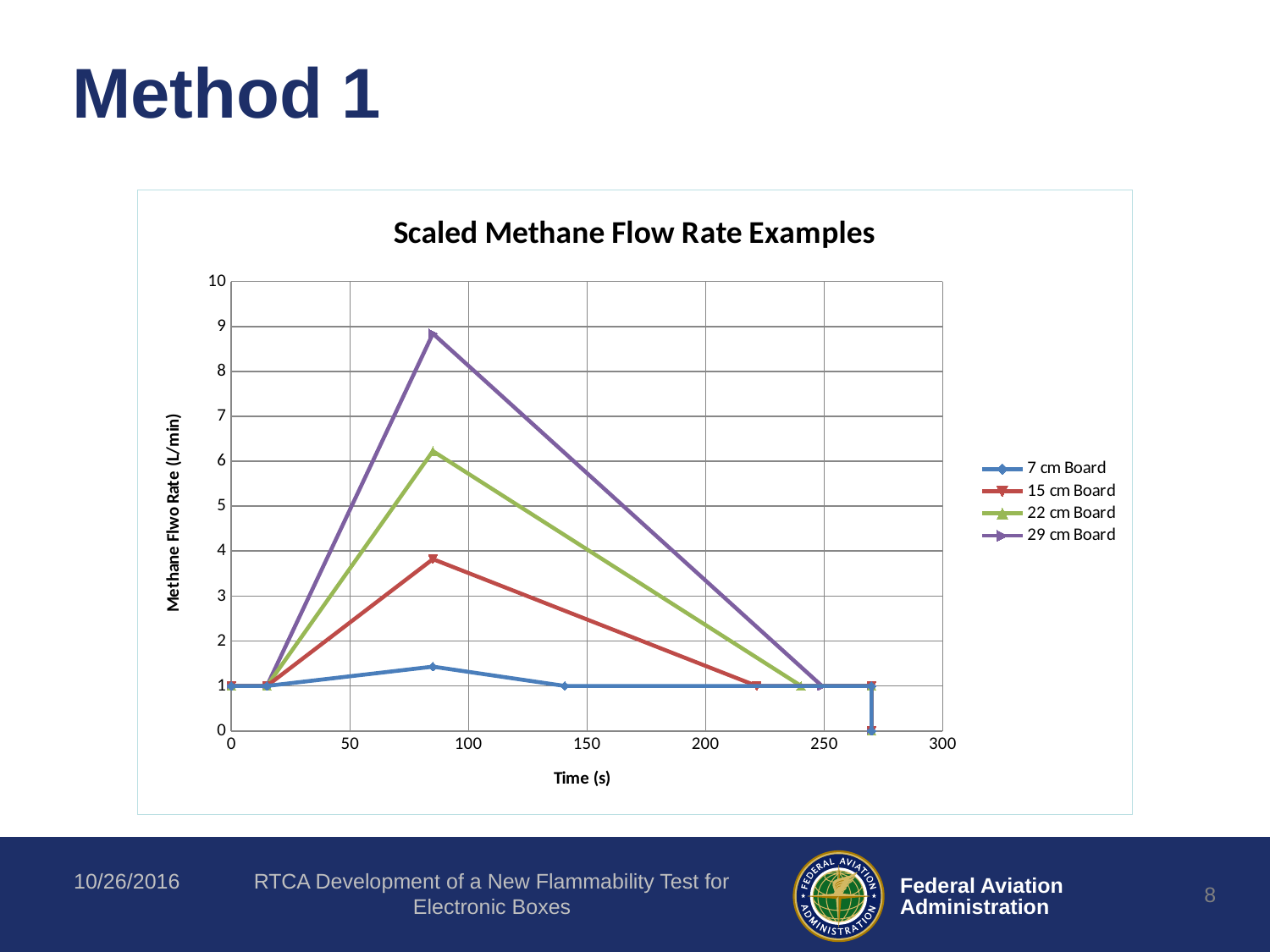
Is the peak value for the 7 cm Board greater or less than 2 L/min? less Which series has the lowest peak methane flow rate? 7 cm Board Is the peak value for the 15 cm Board greater or less than 3 L/min? greater Is the peak value for the 22 cm Board greater or less than 7 L/min? less After reaching its peak, does the 29 cm Board flow rate rise or fall as time increases? fall What is the title of the chart? Scaled Methane Flow Rate Examples What is the label of the x axis? Time (s) Which series reaches the highest peak methane flow rate? 29 cm Board What kind of chart is shown on the slide? line chart Which series has a higher peak flow rate, the 15 cm Board or the 22 cm Board? 22 cm Board How many series does the chart's legend list? 4